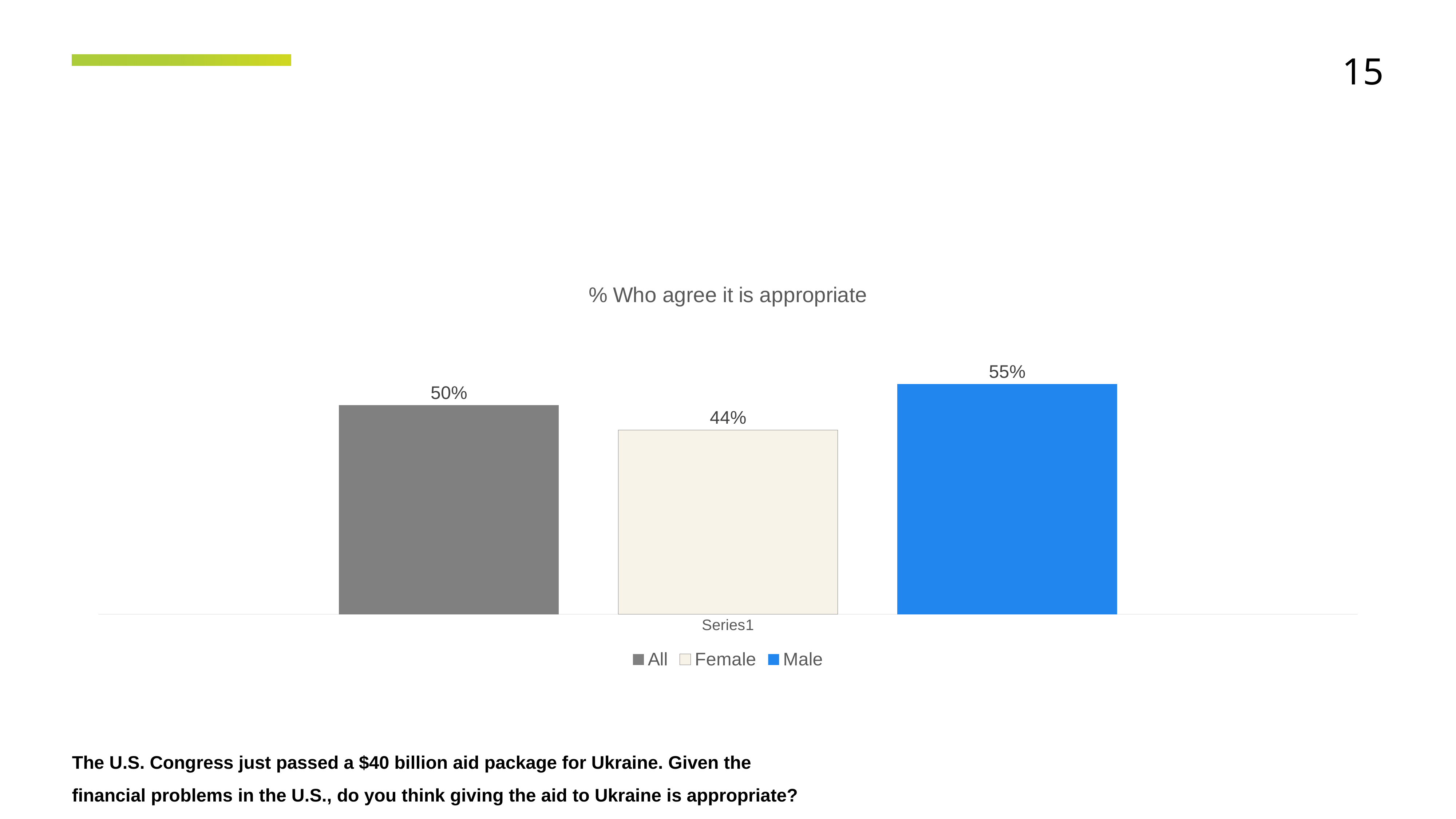
How many series does the legend list? 3 What is the value for Male in the chart? 55% What is the value for Female in the chart? 44% Which is larger, the value for Male or the value for All? Male Which group has the lowest percentage who agree it is appropriate? Female Which group has the highest percentage who agree it is appropriate? Male What colour is the bar for Male? Blue What kind of chart is shown on the slide? Bar chart What is the value for All in the chart? 50% What is the difference between the All and Female values? 6% What is the difference between the Male and Female values? 11% What is the title of the chart? % Who agree it is appropriate